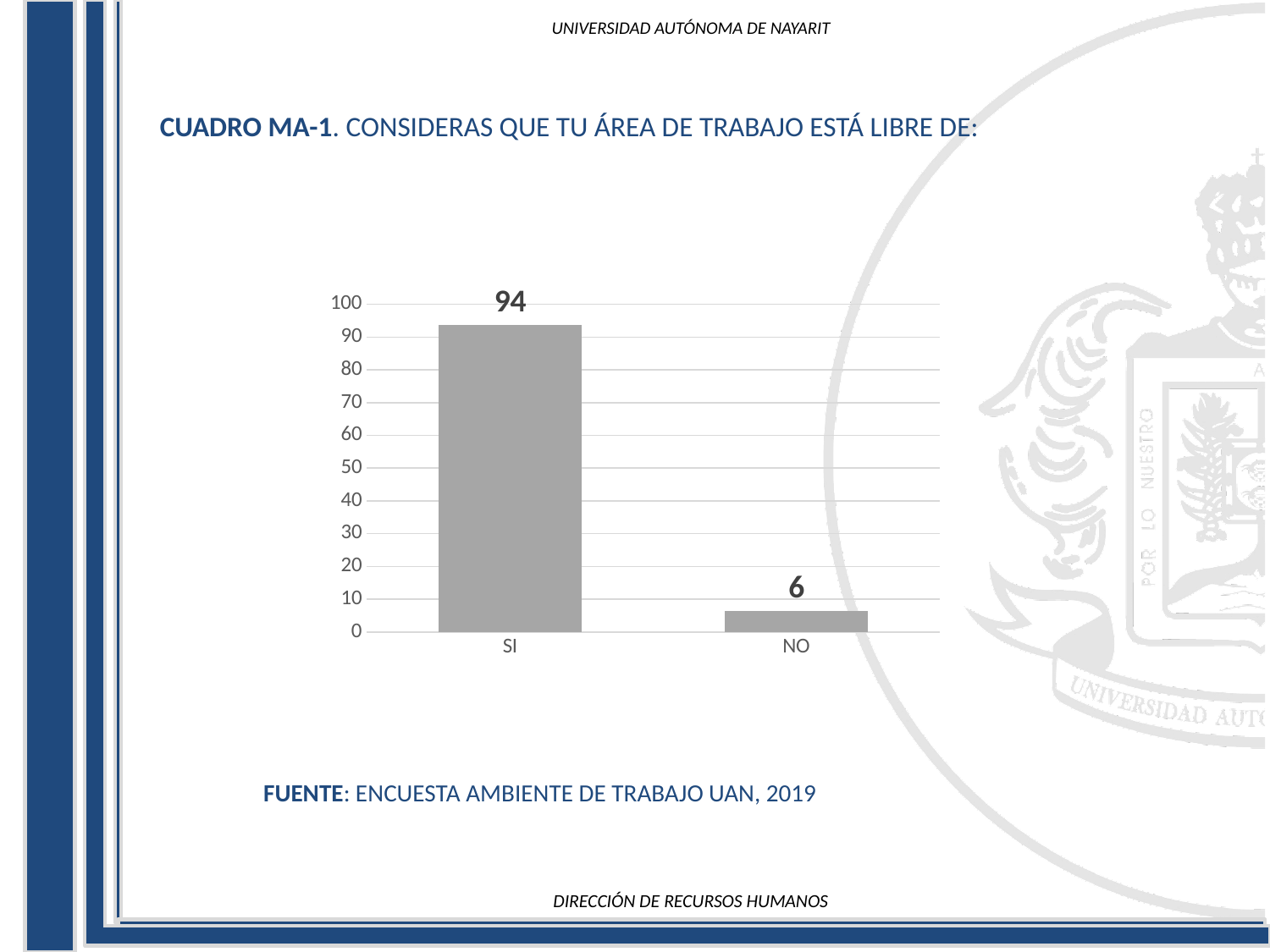
What kind of chart is shown on the slide? bar chart What is the total of the two values shown in the chart? 100 How many categories are shown on the x axis? 2 Which category has the highest value? SI Which is larger, the value for SI or the value for NO? SI What is the maximum value shown on the vertical axis? 100 What is the value for NO? 6 Is the value for SI greater or less than 50? greater What is the value for SI? 94 Is the value for NO greater or less than 10? less Which category has the lowest value? NO What is the difference between the values for SI and NO? 88